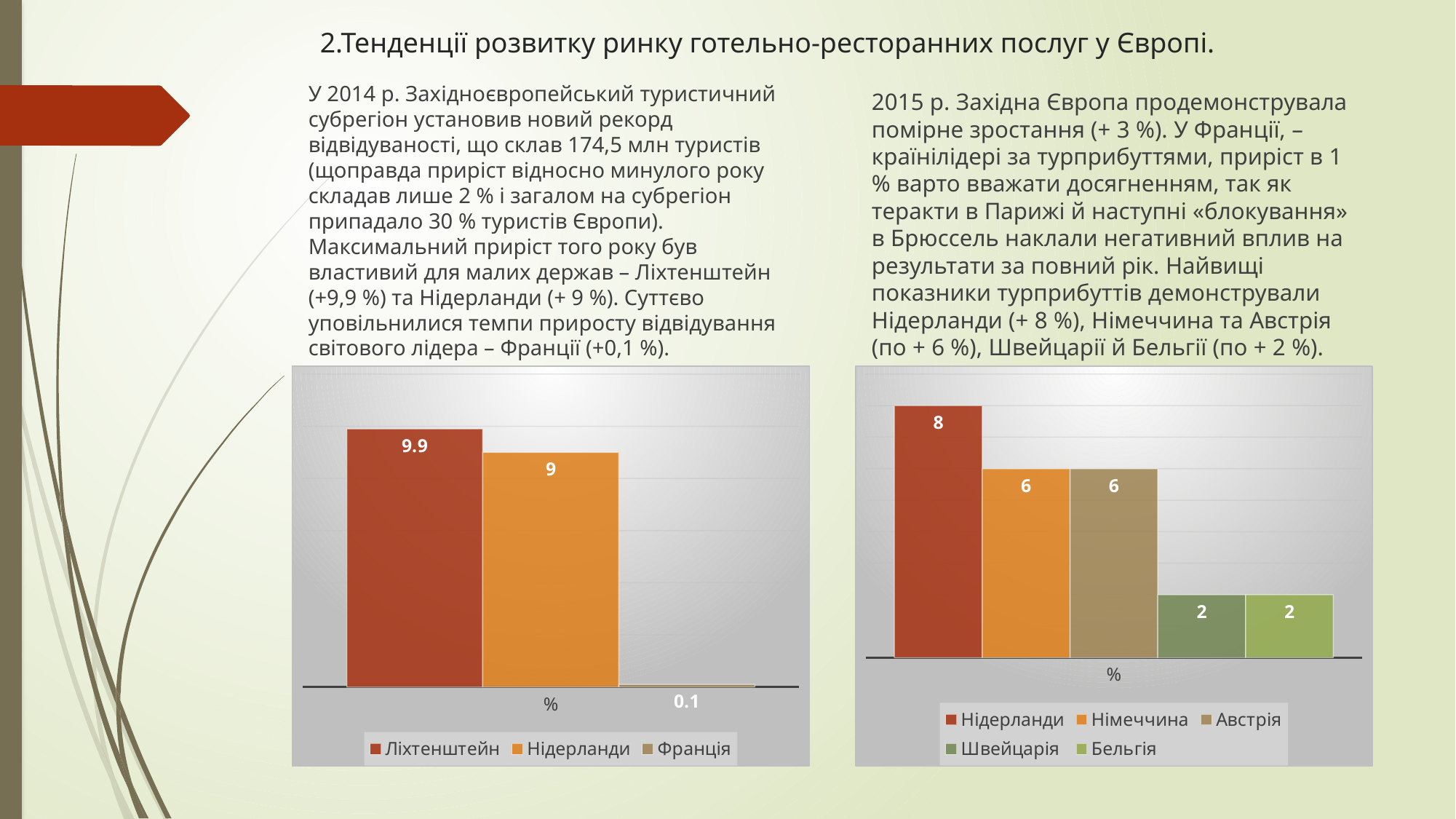
In the left chart, what is the difference between the values for Ліхтенштейн and Нідерланди? 0.9 In the left chart, what is the value for Ліхтенштейн? 9.9 In the right chart, which series has the highest value? Нідерланди In the right chart, what is the value for Нідерланди? 8 In the left chart, how many series does the legend list? 3 In the right chart, how many series does the legend list? 5 In the right chart, what is the difference between the values for Нідерланди and Німеччина? 2 In the right chart, what is the value for Швейцарія? 2 In the left chart, what is the value for Франція? 0.1 What type of chart is the right chart? Bar chart In the left chart, which series has the highest value? Ліхтенштейн In the left chart, which series has the lowest value? Франція